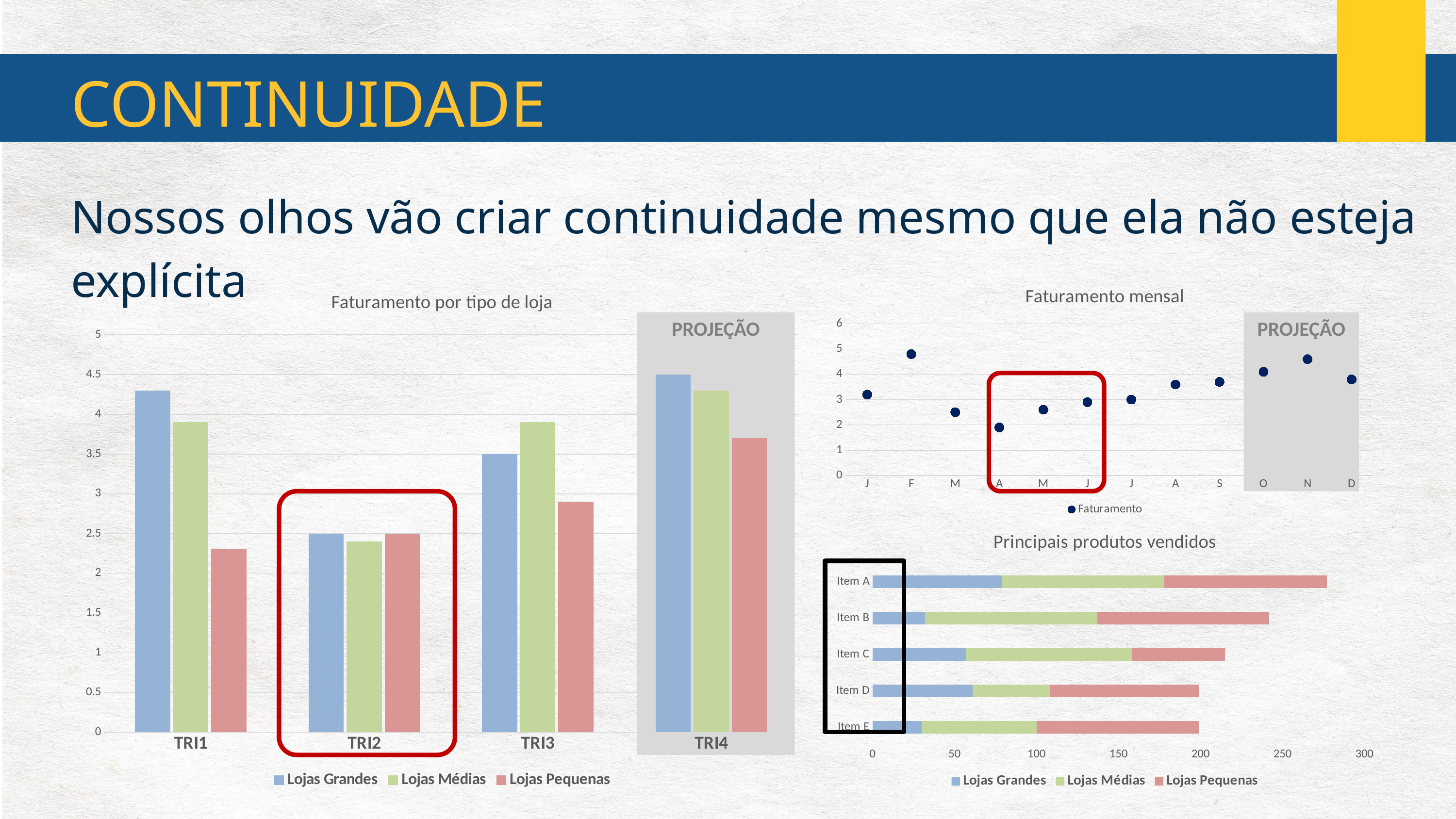
In the "Principais produtos vendidos" chart, is the Lojas Grandes value for Item B greater or less than 50? less In the "Faturamento por tipo de loja" chart, which quarter has the lowest value for Lojas Médias? TRI2 In the "Faturamento por tipo de loja" chart, which is larger in TRI3: Lojas Grandes or Lojas Médias? Lojas Médias In the "Faturamento por tipo de loja" chart, how many series does the legend list? 3 What kind of chart is "Faturamento por tipo de loja"? bar chart In the "Principais produtos vendidos" chart, which item has the longest total bar? Item A In the "Faturamento por tipo de loja" chart, which quarter has the highest value for Lojas Grandes? TRI4 In the "Faturamento por tipo de loja" chart, how many quarters are shown on the x axis? 4 In the "Faturamento mensal" chart, is the value for F greater or less than 4? greater In the "Faturamento mensal" chart, which month has the lowest value? A In the "Faturamento mensal" chart, how many months are plotted? 12 In the "Faturamento por tipo de loja" chart, is the value for Lojas Grandes in TRI1 greater or less than 4? greater